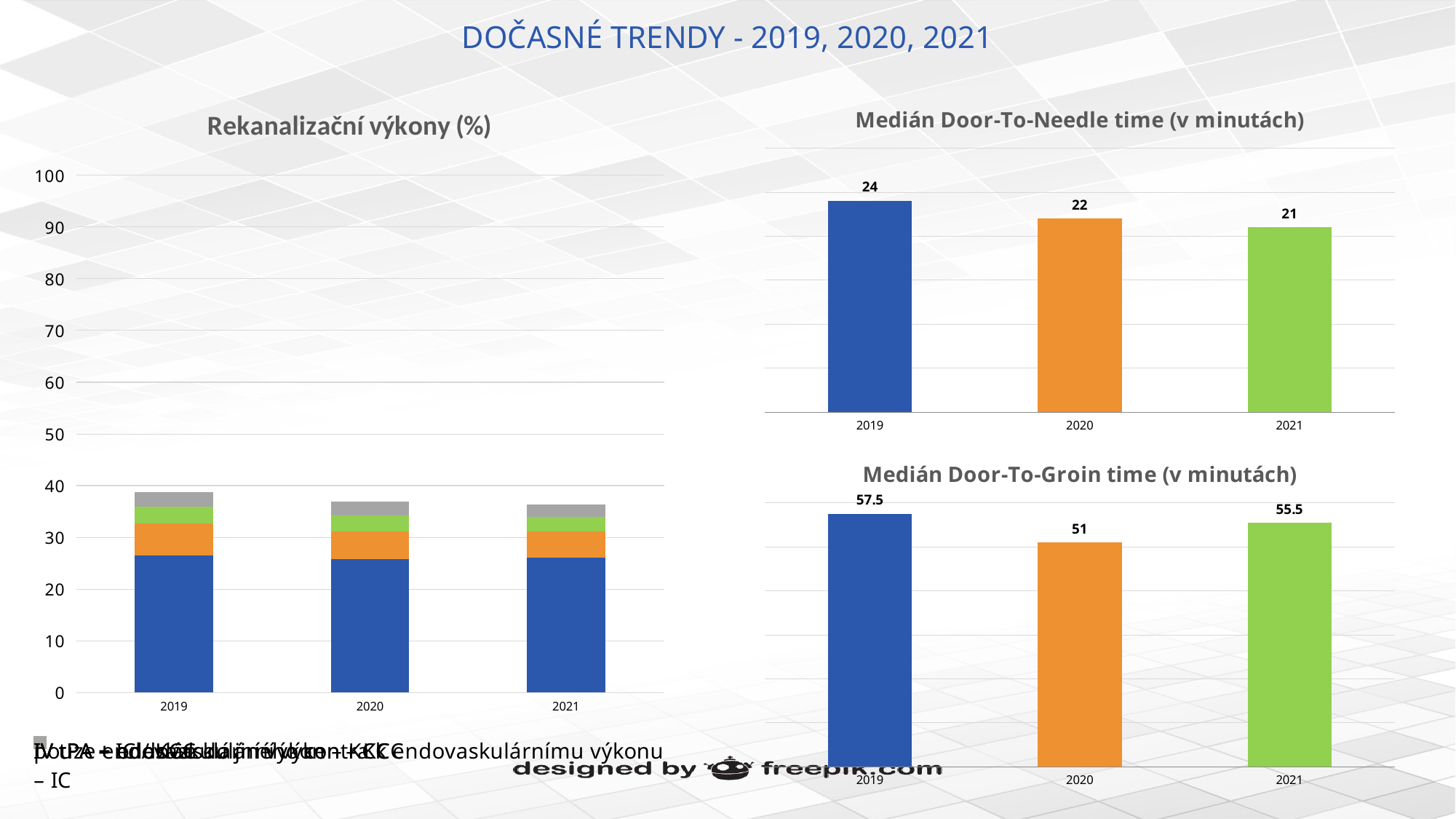
In the 'Rekanalizační výkony (%)' chart, is the total stacked value for 2019 greater or less than 50? less In the 'Medián Door-To-Groin time (v minutách)' chart, what is the value for 2021? 55.5 In the 'Medián Door-To-Groin time (v minutách)' chart, which is larger, the value for 2020 or 2021? 2021 In the 'Medián Door-To-Groin time (v minutách)' chart, what is the value for 2020? 51 In the 'Medián Door-To-Needle time (v minutách)' chart, what is the difference between the 2019 and 2021 values? 3 In the 'Medián Door-To-Groin time (v minutách)' chart, what is the difference between the 2019 and 2020 values? 6.5 What kind of chart is 'Rekanalizační výkony (%)'? stacked bar chart In the 'Medián Door-To-Needle time (v minutách)' chart, which year has the lowest value? 2021 In the 'Medián Door-To-Needle time (v minutách)' chart, what is the value for 2021? 21 In the 'Medián Door-To-Needle time (v minutách)' chart, do the values rise or fall from 2019 to 2021? fall In the 'Medián Door-To-Needle time (v minutách)' chart, what is the value for 2019? 24 In the 'Medián Door-To-Groin time (v minutách)' chart, which year has the highest value? 2019